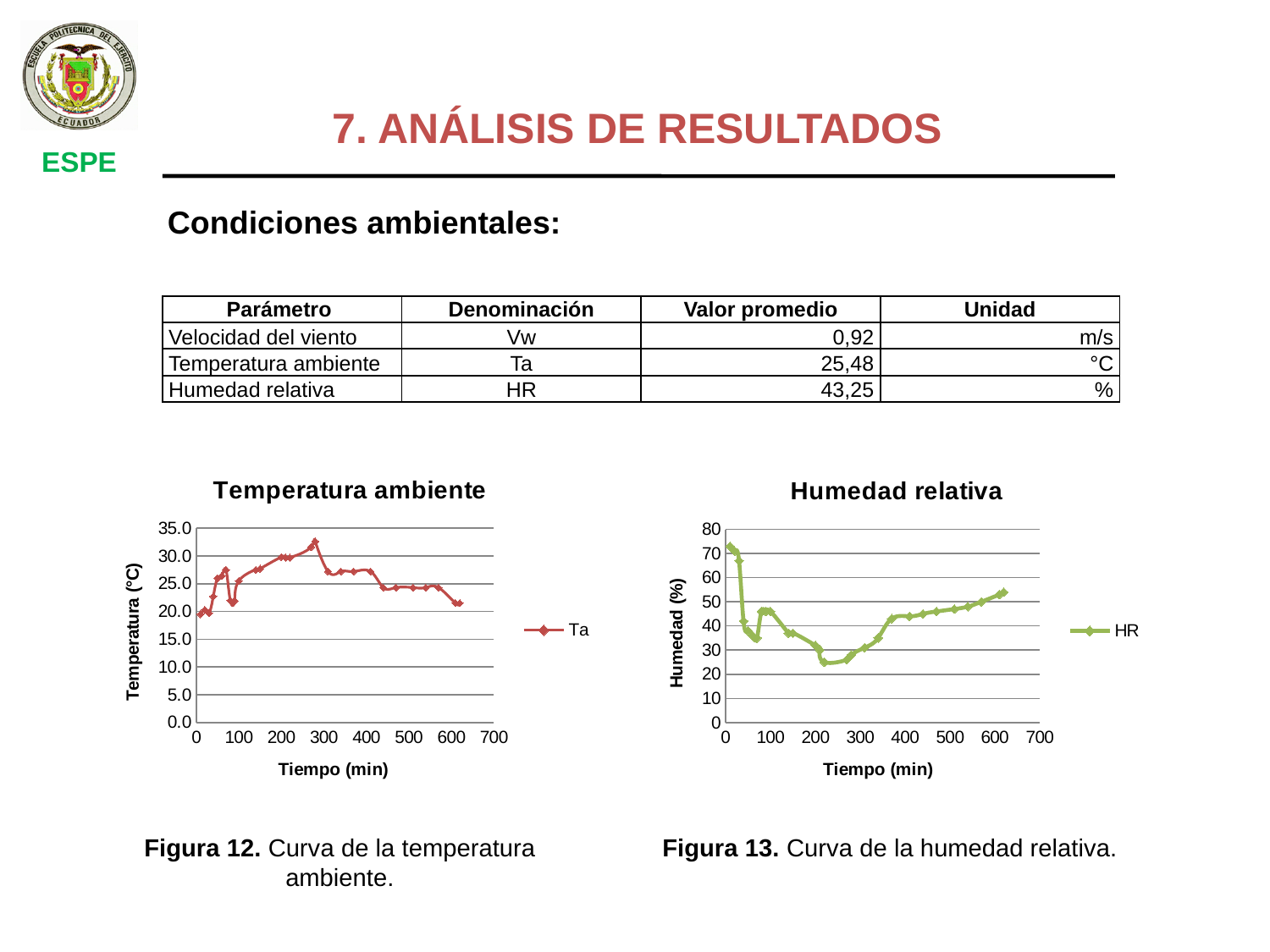
What kind of chart is the 'Humedad relativa' chart? line chart In the 'Humedad relativa' chart, what is the legend entry for the plotted series? HR In the 'Temperatura ambiente' chart, how many series does the legend list? 1 In the 'Humedad relativa' chart, is the humidity at the last plotted point (around 620 min) greater or less than 40? greater In the 'Temperatura ambiente' chart, what is the label of the y axis? Temperatura (°C) What kind of chart is the 'Temperatura ambiente' chart? line chart In the 'Humedad relativa' chart, is the humidity at the first plotted point (time 0) greater or less than 60? greater In the 'Humedad relativa' chart, do the values rise or fall between 300 and 600 min? rise In the 'Humedad relativa' chart, is the lowest humidity value reached greater or less than 30? less In the 'Humedad relativa' chart, do the values rise or fall between 0 and 200 min? fall